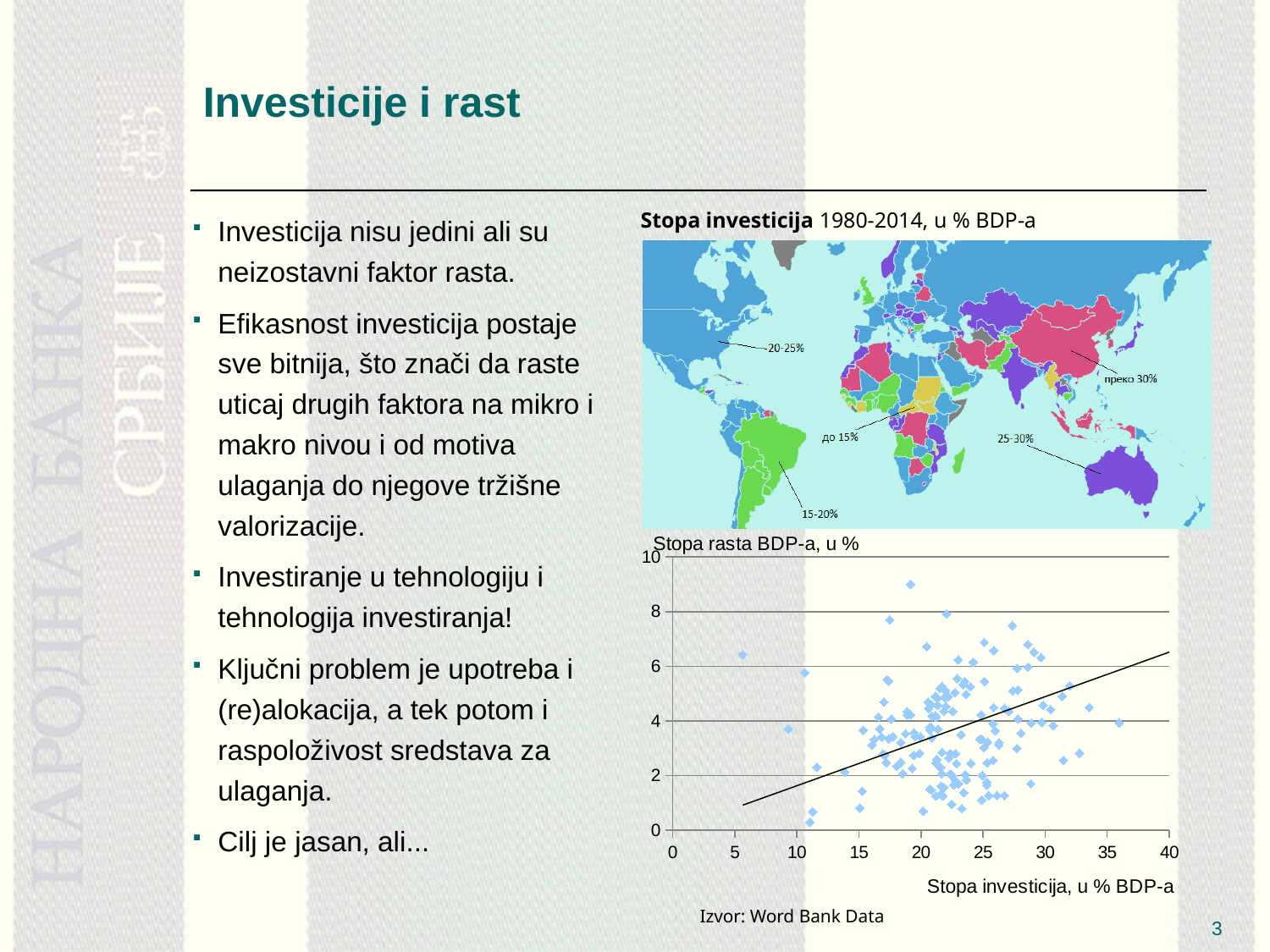
What is the label of the horizontal axis of the scatter chart? Stopa investicija, u % BDP-a What is the label of the vertical axis of the scatter chart? Stopa rasta BDP-a, u % In the scatter chart, is the GDP growth rate of the highest plotted point greater or less than 8? greater In the scatter chart, is the value of the trend line at its left end (investment rate around 5) greater or less than 2? less In the scatter chart, does the fitted trend line rise or fall as the investment rate (x axis) increases? rises What is the highest tick value shown on the vertical axis of the scatter chart? 10 What is the highest tick value shown on the horizontal axis of the scatter chart? 40 How many investment-rate categories are labelled on the map 'Stopa investicija 1980-2014, u % BDP-a'? 5 On the map 'Stopa investicija 1980-2014, u % BDP-a', which investment-rate category is Australia labelled with? 25-30% In the scatter chart, is the value of the trend line at the right end (investment rate 40) greater or less than 6? greater On the map 'Stopa investicija 1980-2014, u % BDP-a', which investment-rate category is Brazil labelled with? 15-20% What kind of chart is the lower chart on the slide (the one with the axis 'Stopa investicija, u % BDP-a')? scatter chart